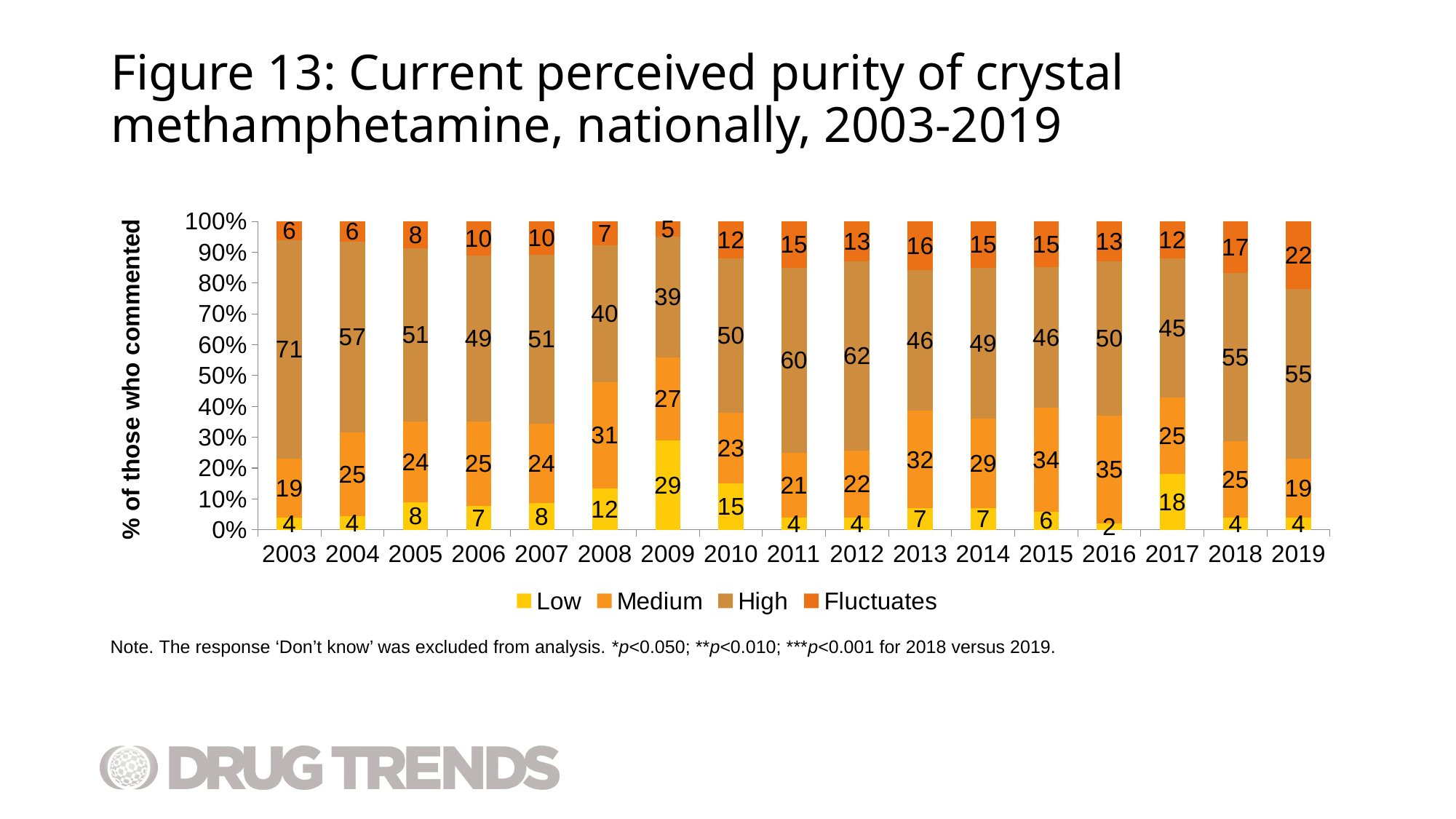
In which year is the High series at its highest value? 2003 Which is larger: the Medium value in 2015 or the Medium value in 2019? 2015 In which year is the Low series at its lowest value? 2016 What is the value for Low in 2009? 29 Does the Fluctuates value rise or fall from 2017 to 2019? Rise What percentage of those who commented rated the purity of crystal methamphetamine as High in 2003? 71 What kind of chart is shown on the slide? Stacked bar chart How many series does the legend list? 4 How many years are shown on the x axis? 17 What is the difference between the High value in 2003 and the High value in 2009? 32 What is the value for Fluctuates in 2019? 22 What is the value for Medium in 2016? 35